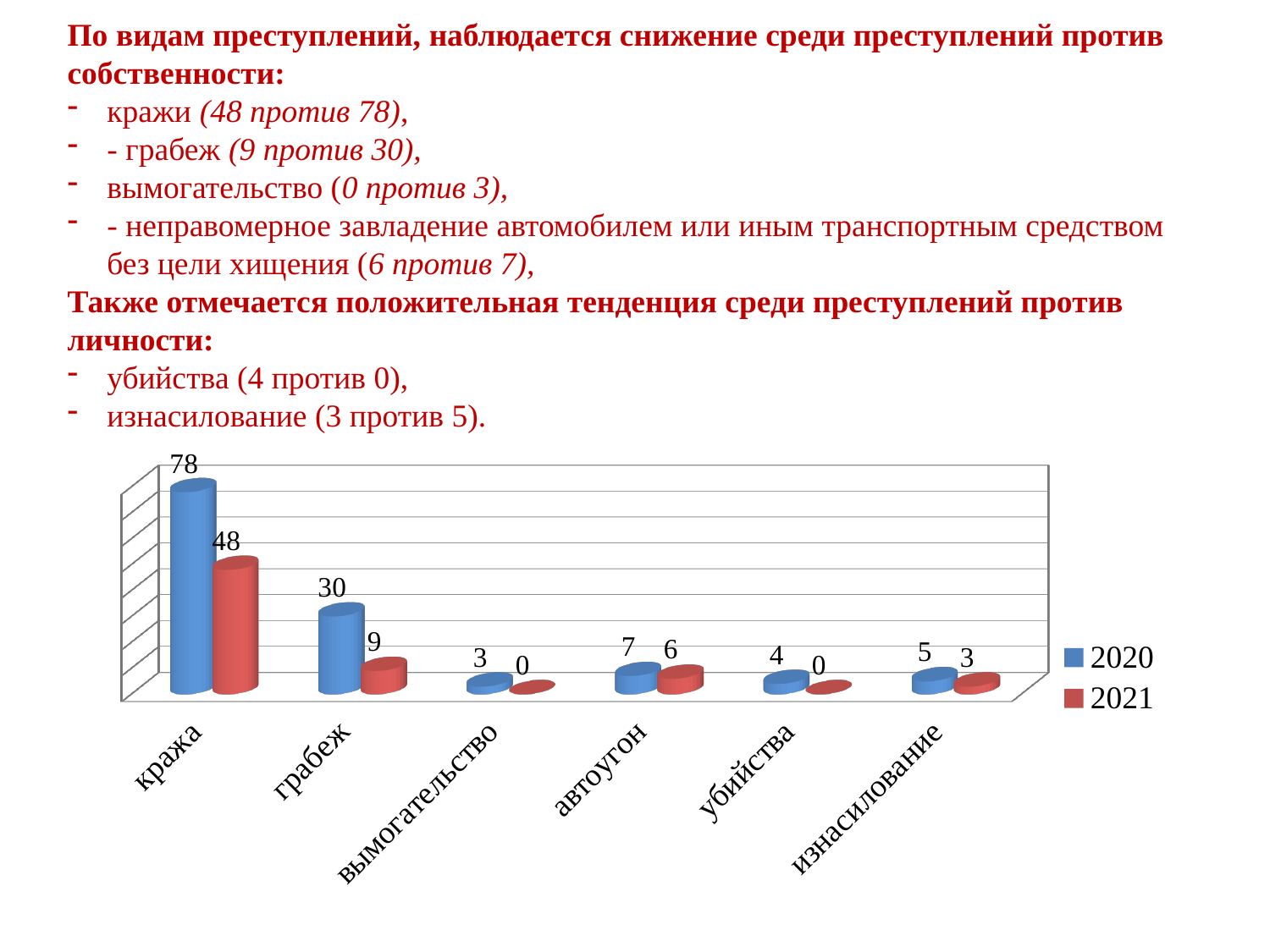
What is the value for убийства in 2021? 0 Which category has the highest value in 2020? кража Which series is shown in red in the legend? 2021 What is the difference between the 2020 and 2021 values for кража? 30 What is the value for автоугон in 2020? 7 How many series does the legend list? 2 What kind of chart is shown? bar chart What is the value for грабеж in 2021? 9 What is the value for кража in 2020? 78 Which is larger, the 2020 value for грабеж or the 2020 value for изнасилование? 2020 value for грабеж How many categories are shown on the x axis? 6 Which category has the lowest value in 2020? вымогательство